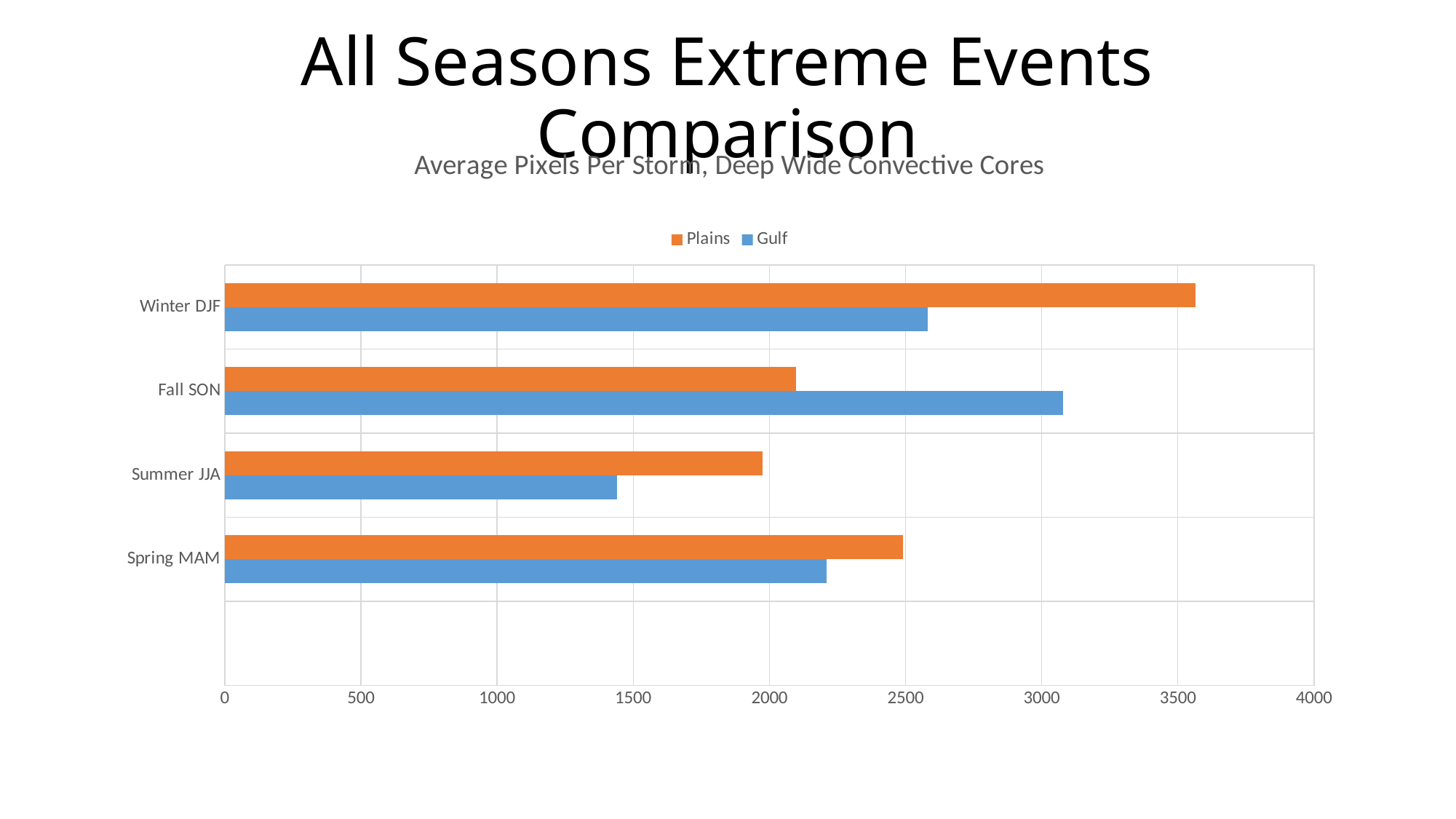
Is the Gulf value for Summer JJA greater or less than 1500? less For Winter DJF, which is larger, Plains or Gulf? Plains How many series does the legend list? 2 Which season has the highest Plains value? Winter DJF What is the subtitle shown above the chart? Average Pixels Per Storm, Deep Wide Convective Cores Which season has the highest Gulf value? Fall SON For Fall SON, which is larger, Plains or Gulf? Gulf What kind of chart is shown on the slide? bar chart How many seasons (categories) are plotted on the chart? 4 Which season has the lowest Gulf value? Summer JJA Is the Gulf value for Fall SON greater or less than 3000? greater Is the Plains value for Winter DJF greater or less than 3000? greater